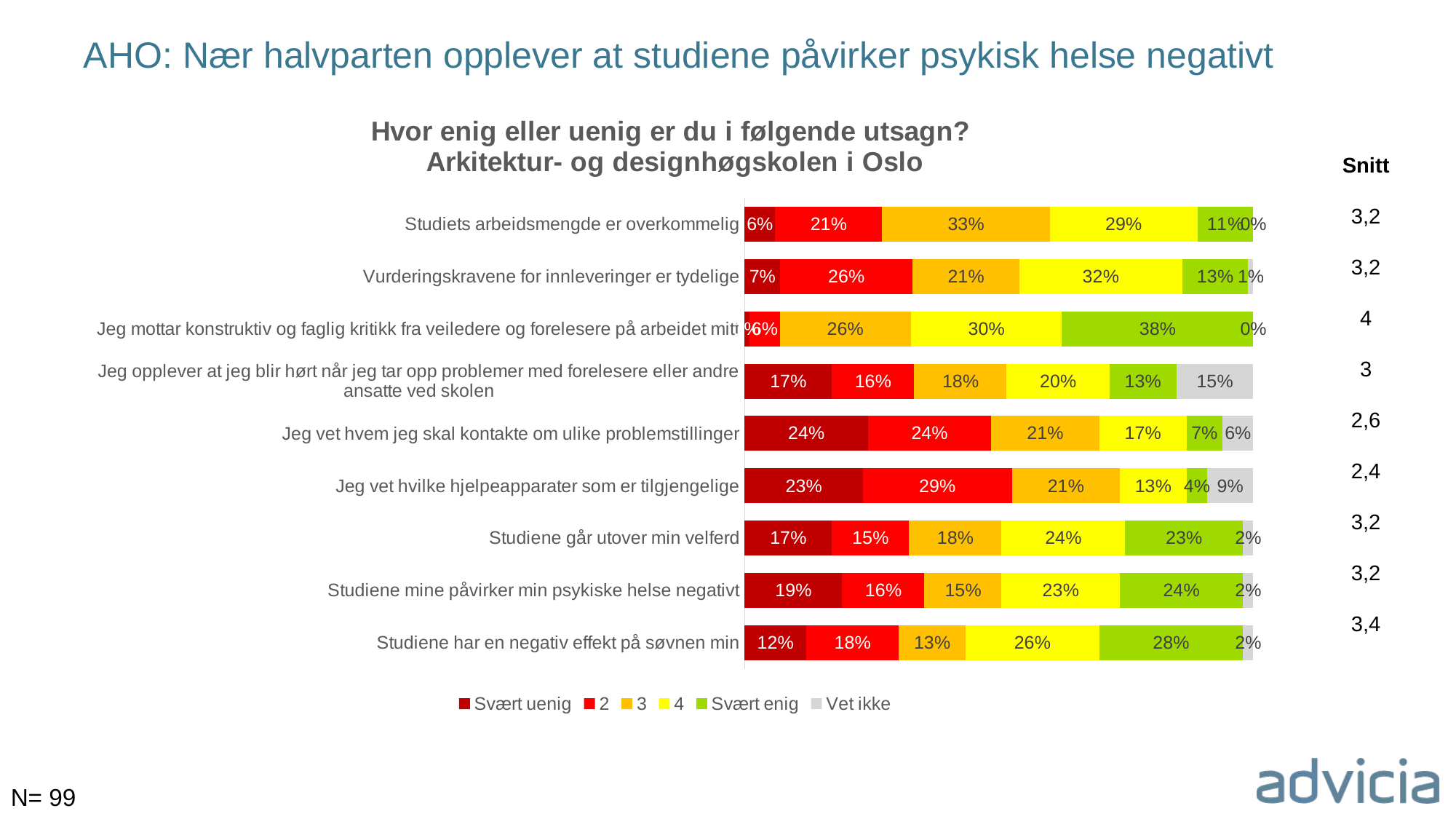
What is the 'Vet ikke' value for 'Jeg opplever at jeg blir hørt når jeg tar opp problemer med forelesere eller andre ansatte ved skolen'? 15% What kind of chart is shown on the slide? Stacked bar chart What is the 'Svært enig' value for 'Studiene har en negativ effekt på søvnen min'? 28% Which statement has the lowest 'Snitt' value? Jeg vet hvilke hjelpeapparater som er tilgjengelige What is the difference between the '2' value and the 'Svært uenig' value for 'Jeg vet hvilke hjelpeapparater som er tilgjengelige'? 6% How many statements (categories) are plotted in the chart? 9 Which is larger for 'Studiene mine påvirker min psykiske helse negativt': the 'Svært enig' value or the 'Svært uenig' value? Svært enig What is the second line of the chart title? Arkitektur- og designhøgskolen i Oslo Which statement has the highest 'Svært enig' share? Jeg mottar konstruktiv og faglig kritikk fra veiledere og forelesere på arbeidet mitt How many series does the legend list? 6 What is the 'Snitt' value shown for 'Jeg mottar konstruktiv og faglig kritikk fra veiledere og forelesere på arbeidet mitt'? 4 What is the 'Svært uenig' value for 'Jeg vet hvem jeg skal kontakte om ulike problemstillinger'? 24%